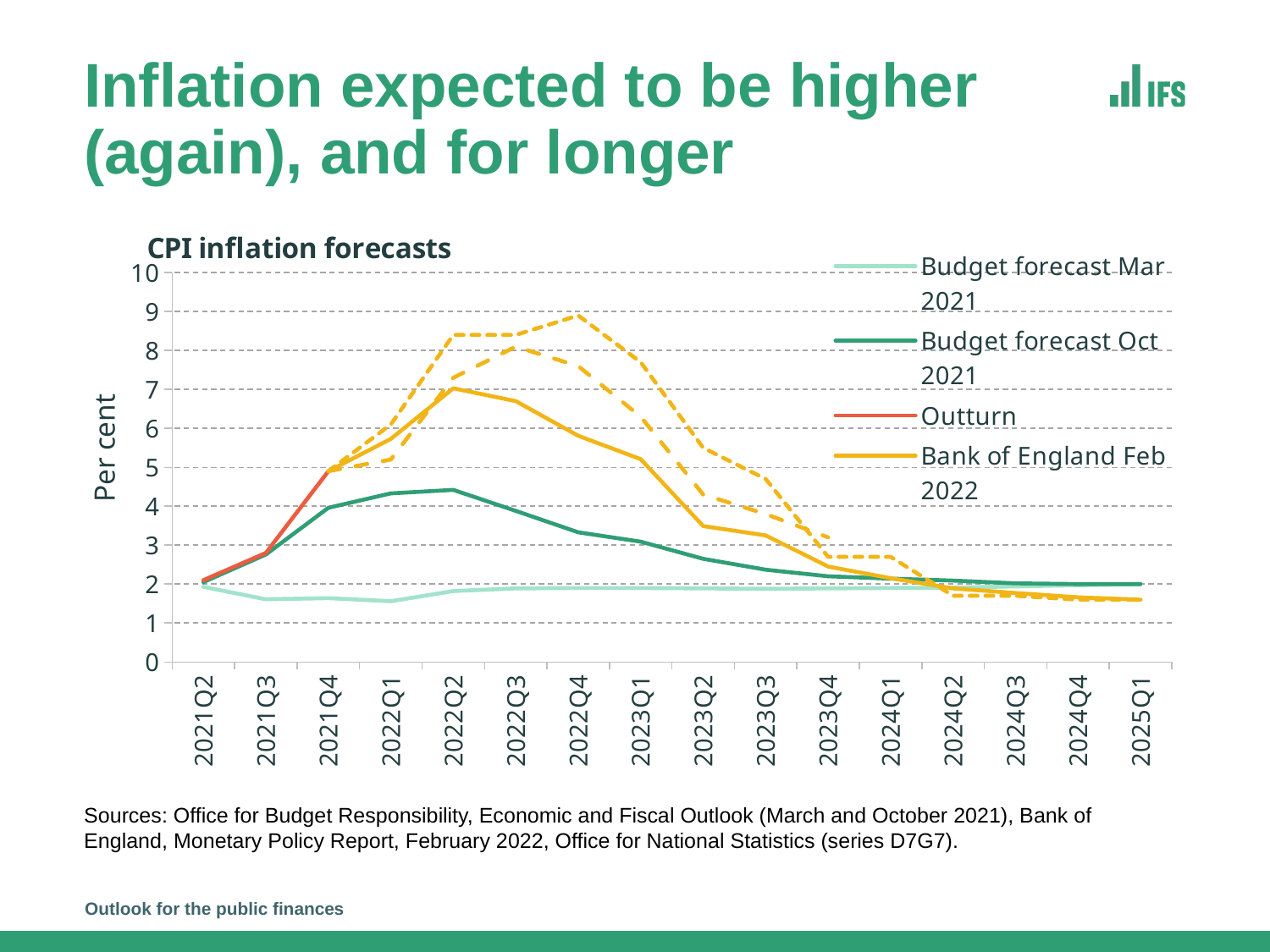
Is the Outturn value for 2021Q4 greater or less than 4? greater Does the Bank of England Feb 2022 series rise or fall from 2022Q2 to 2025Q1? fall How many quarters are shown along the x axis of the chart? 16 Is the Bank of England Feb 2022 value for 2022Q2 greater or less than 6? greater What is the label on the vertical axis of the chart? Per cent Which series in the legend is lowest at 2022Q2? Budget forecast Mar 2021 Is the Budget forecast Mar 2021 value for 2022Q1 greater or less than 2? less What kind of chart is shown on the slide? line chart At 2022Q3, which is higher: Bank of England Feb 2022 or Budget forecast Oct 2021? Bank of England Feb 2022 How many series does the legend of the CPI inflation forecasts chart list? 4 What is the title of the chart? CPI inflation forecasts